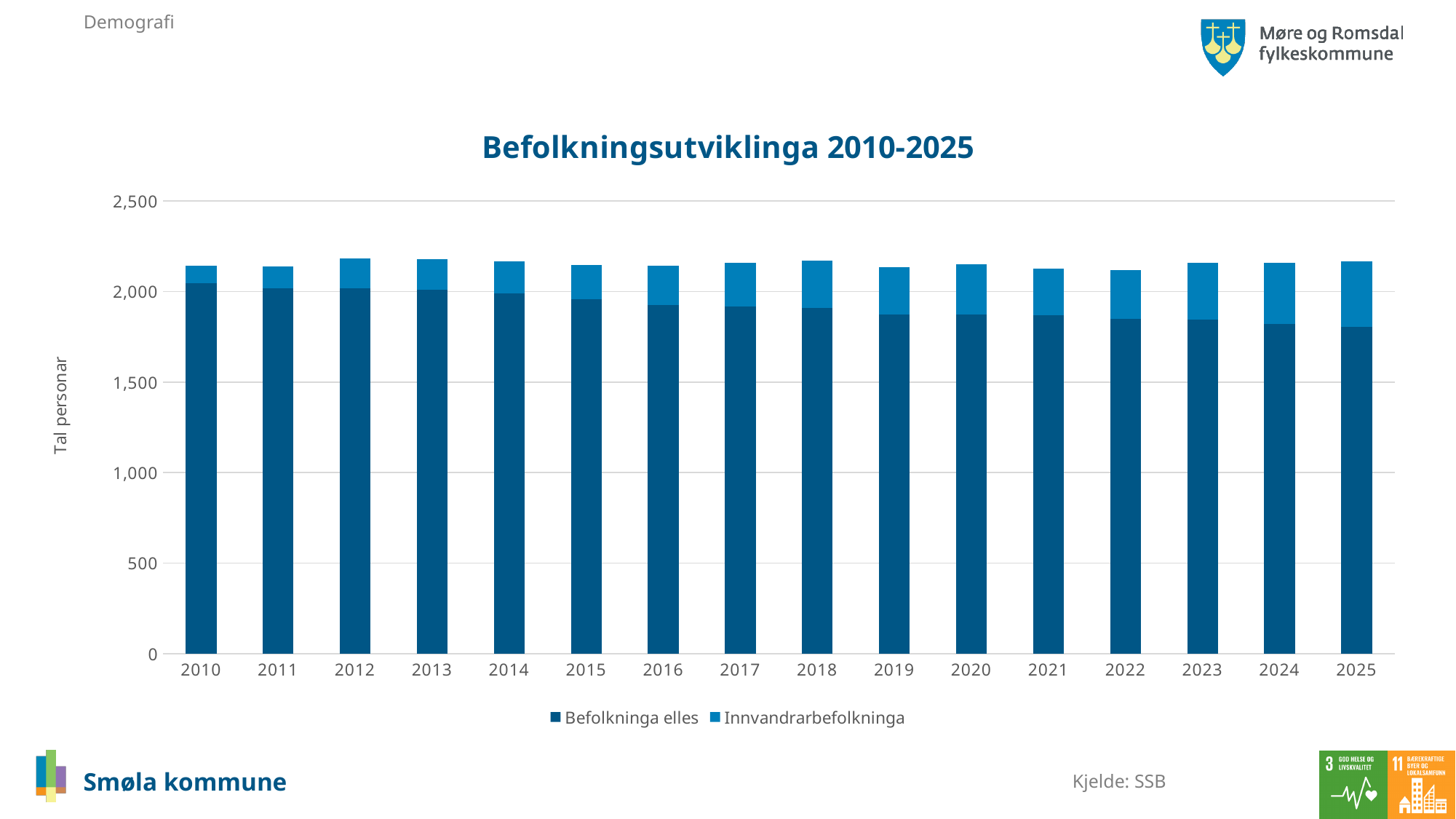
How many series does the legend list? 2 Is the value for Befolkninga elles in 2010 greater or less than 2,000? greater How many years are shown on the x axis? 16 Is the total height of the stacked bar for 2025 greater or less than 2,000? greater Is the value for Befolkninga elles in 2025 greater or less than 2,000? less Which is larger, the Innvandrarbefolkninga value for 2010 or for 2025? 2025 What kind of chart is shown on the slide? Stacked bar chart Do the values for Befolkninga elles generally rise or fall from 2010 to 2025? fall What is the label of the y axis? Tal personar What is the title of the chart? Befolkningsutviklinga 2010-2025 Which is larger, the Befolkninga elles value for 2010 or for 2025? 2010